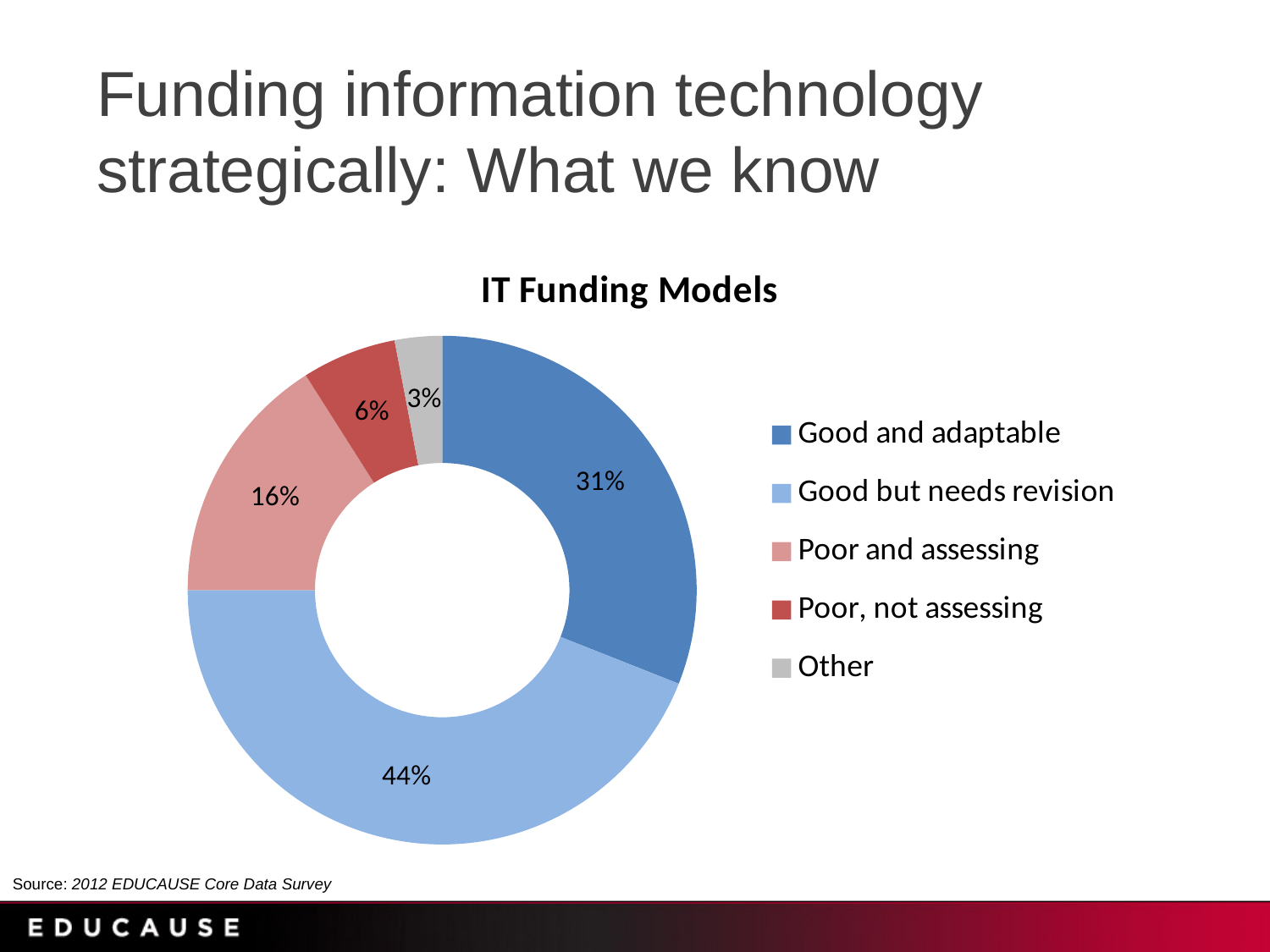
What percentage is shown for 'Poor, not assessing'? 6% What is the difference in percentage points between 'Good but needs revision' and 'Good and adaptable'? 13 Which category has the smallest share of the chart? Other How many categories does the chart show? 5 What percentage is shown for 'Poor and assessing'? 16% Which is larger, 'Poor and assessing' or 'Poor, not assessing'? Poor and assessing What percentage is shown for 'Good and adaptable'? 31% Which category has the largest share of the chart? Good but needs revision What share of the IT Funding Models chart is 'Good but needs revision'? 44% What kind of chart is shown on the slide? Doughnut (pie) chart What percentage is shown for 'Other'? 3% What is the title of the chart? IT Funding Models